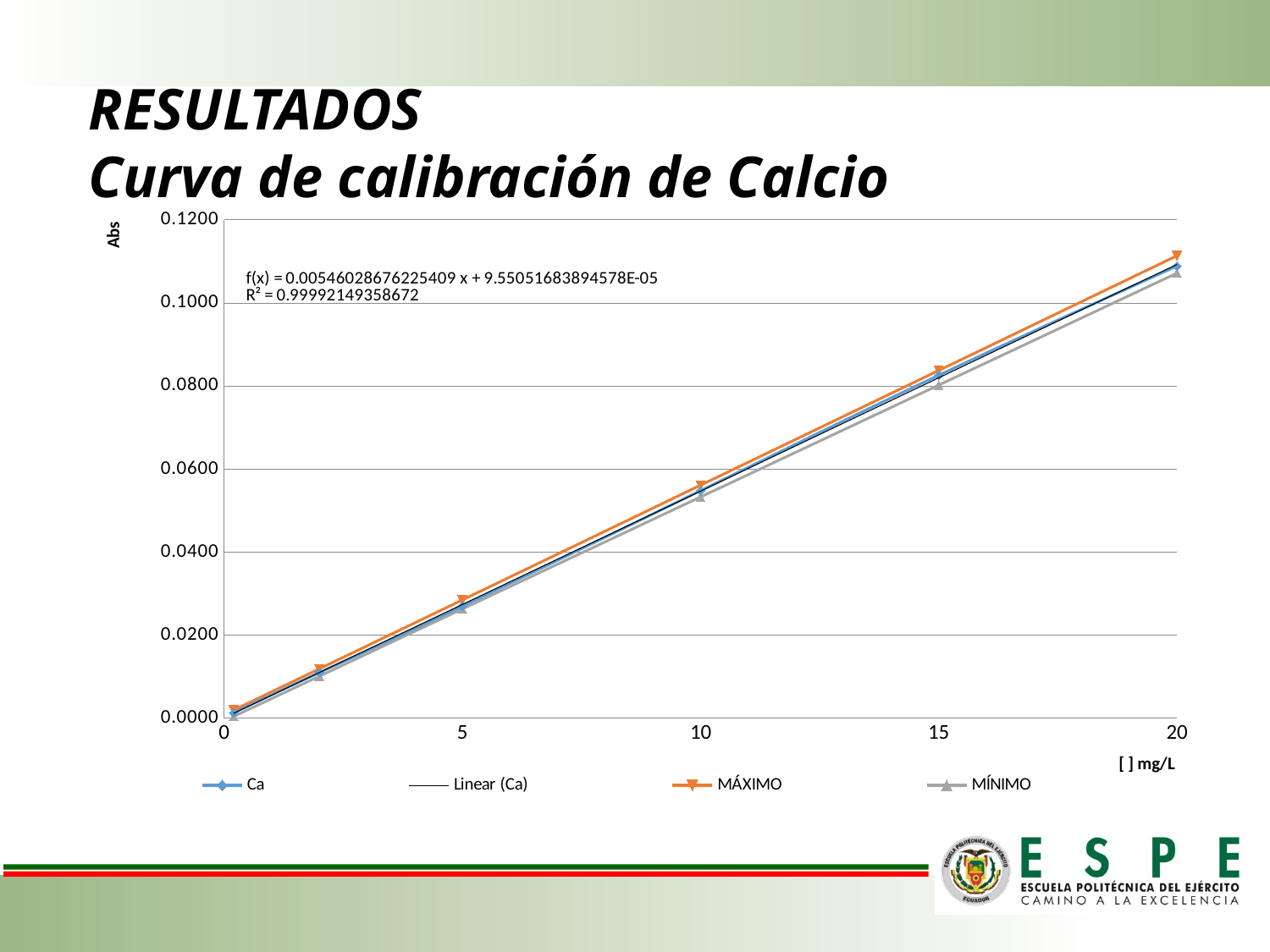
Is the value of the MÁXIMO series at 15 mg/L greater or less than 0.0800? greater Is the value of the Ca series at 10 mg/L greater or less than 0.0600? less What is the label of the y axis? Abs What kind of chart is shown on the slide? line chart Is the value of the MÍNIMO series at 5 mg/L greater or less than 0.0200? greater At 20 mg/L, which series has the higher value, MÁXIMO or MÍNIMO? MÁXIMO Do the absorbance values rise or fall as concentration increases along the x axis? rise What is the highest value shown on the y axis? 0.1200 How many series does the legend list? 4 What is the R² value shown on the chart? 0.99992149358672